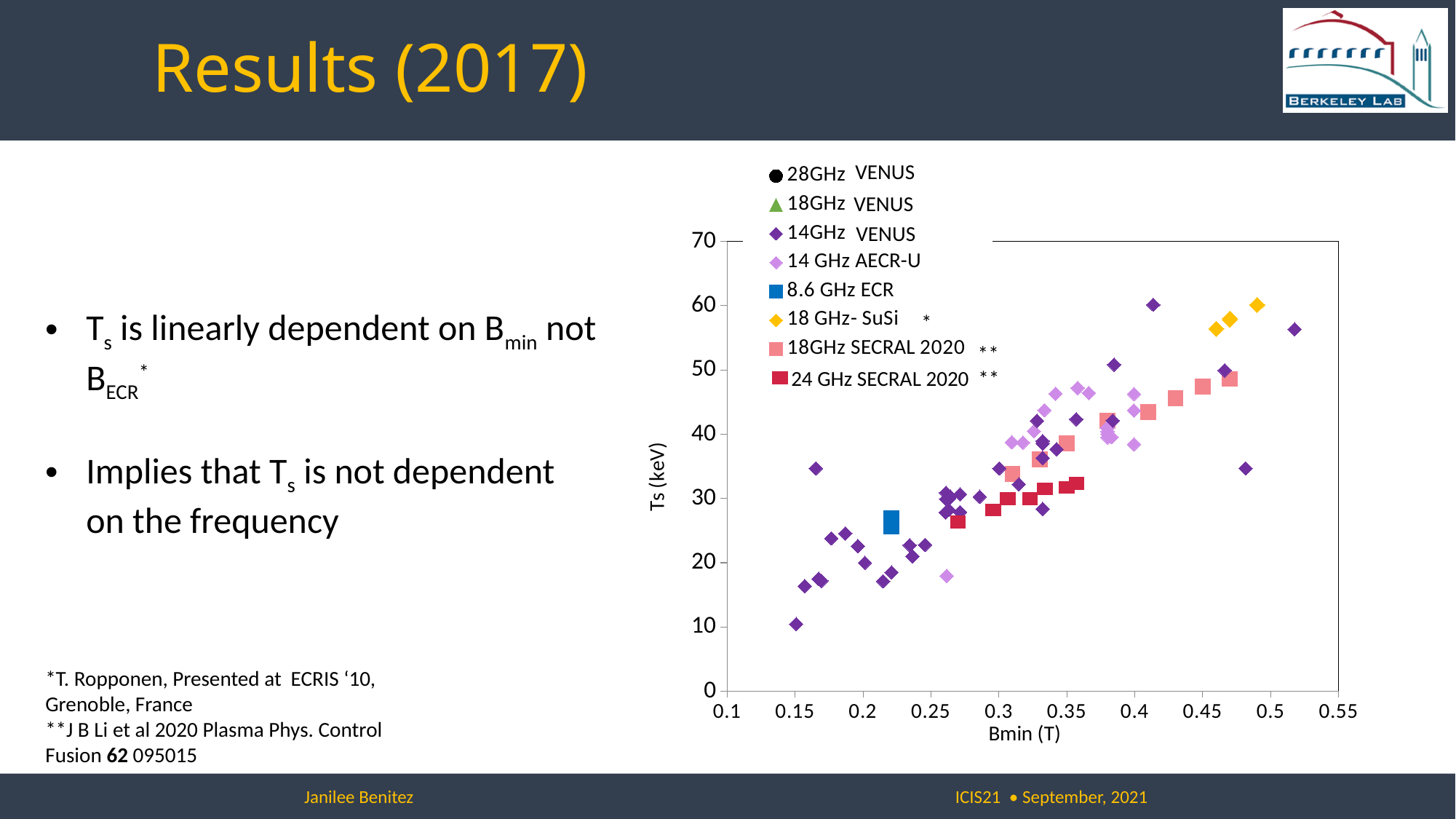
How many series does the chart legend list? 8 Are the Ts values of the 18 GHz- SuSi points greater or less than 50? greater Is the Ts value of the 8.6 GHz ECR point greater or less than 30? less What kind of chart is shown on the slide? scatter chart Do the Ts values generally rise or fall as Bmin increases along the x axis? rise What is the label of the y axis of the chart? Ts (keV) Which has higher Ts values: the 8.6 GHz ECR point or the 18 GHz- SuSi points? 18 GHz- SuSi Is the Ts value of the 8.6 GHz ECR point greater or less than 20? greater What is the label of the x axis of the chart? Bmin (T)